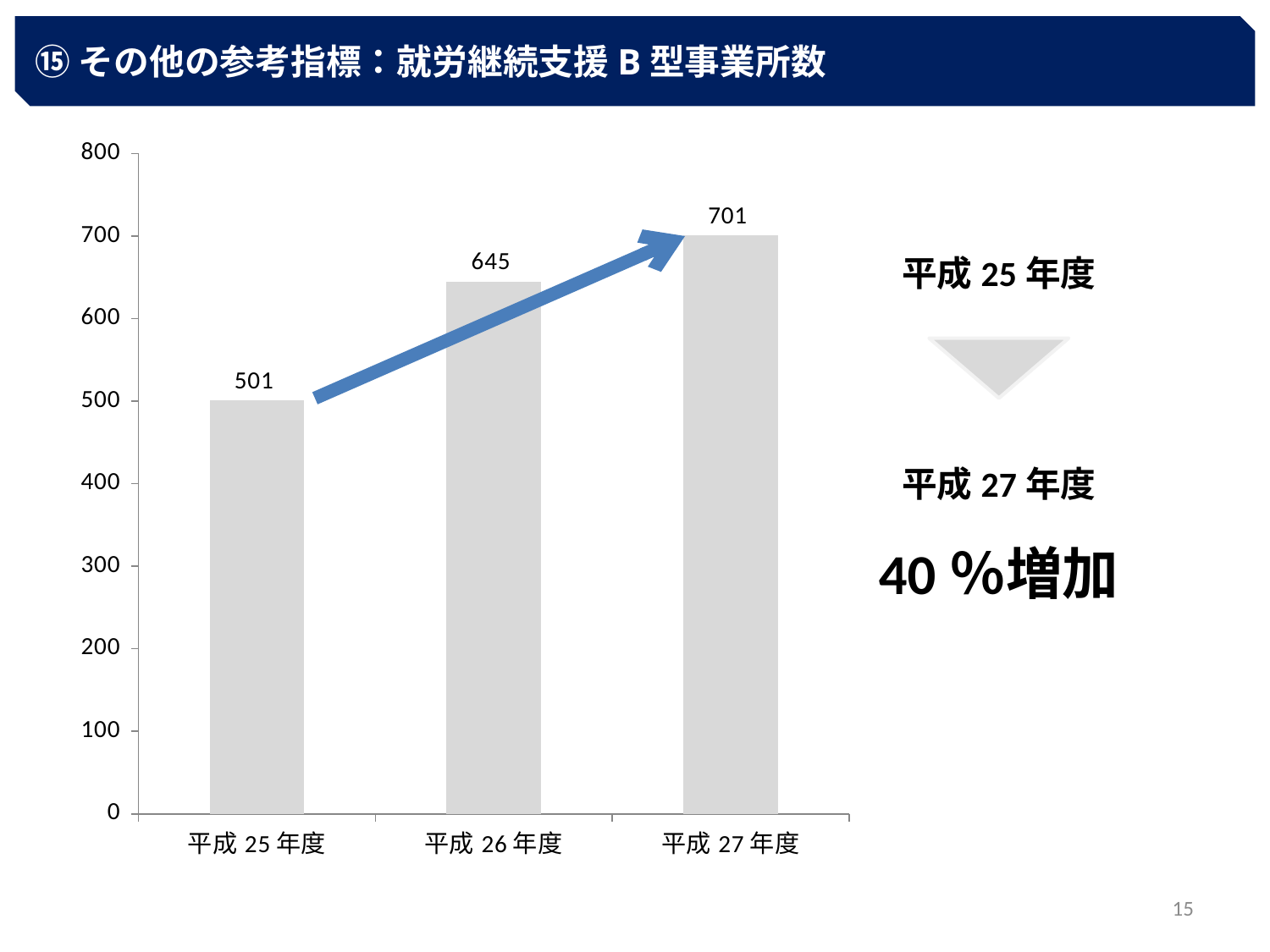
What is the value for 平成 26 年度? 645 Do the values rise or fall from 平成 25 年度 to 平成 27 年度? rise How many years are shown on the x axis? 3 Which year has the highest value? 平成 27 年度 Which year has the lowest value? 平成 25 年度 What is the difference between the values for 平成 27 年度 and 平成 25 年度? 200 What is the difference between the values for 平成 26 年度 and 平成 25 年度? 144 Which is larger, the value for 平成 26 年度 or 平成 27 年度? 平成 27 年度 Is the value for 平成 26 年度 greater or less than 600? greater What is the value for 平成 27 年度? 701 What is the value for 平成 25 年度? 501 What kind of chart is shown on the slide? bar chart